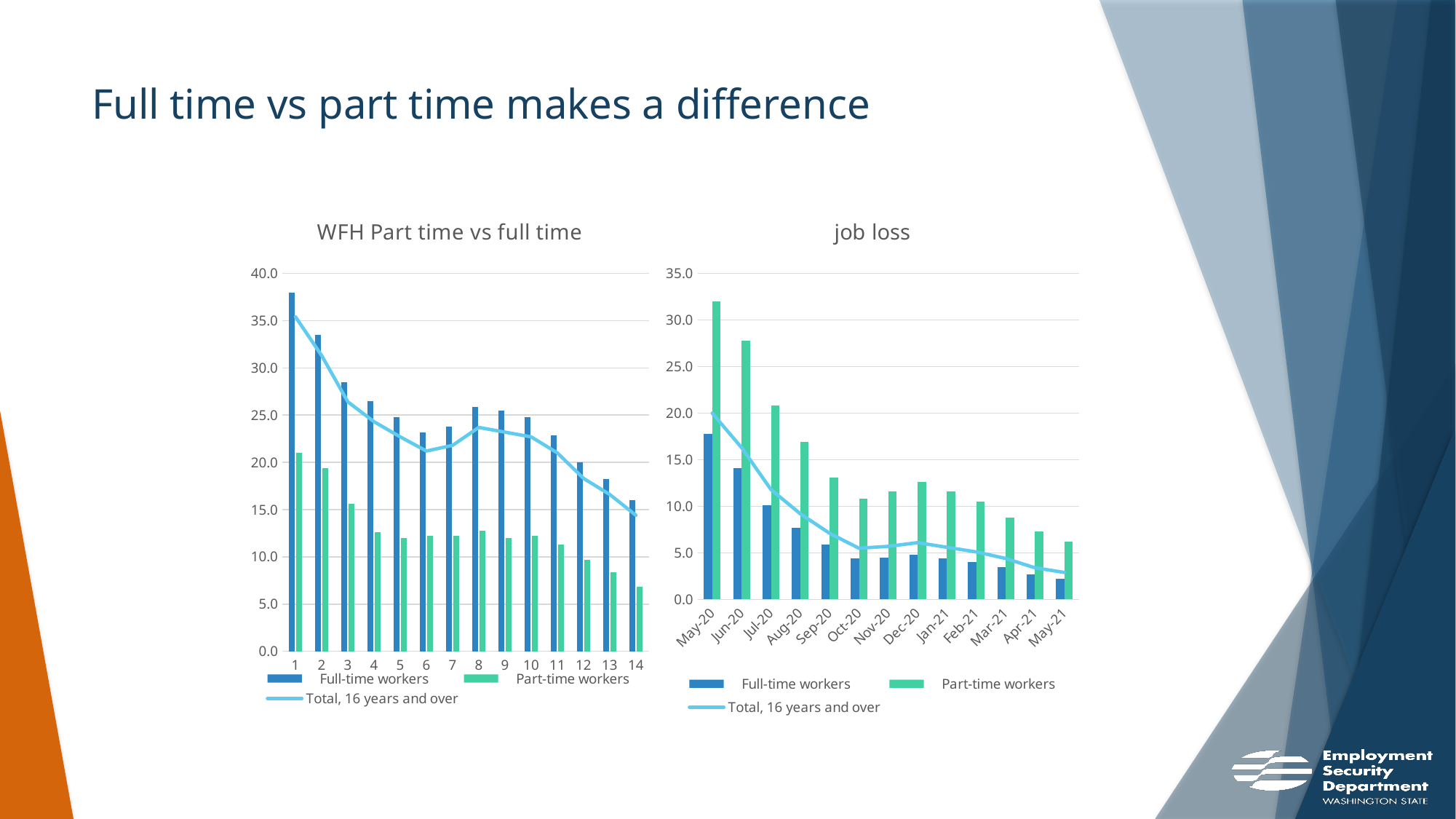
How many months are shown on the x axis of the "job loss" chart? 13 In the "WFH Part time vs full time" chart, is the value for Part-time workers at category 3 greater or less than 20.0? less In the "job loss" chart, does the "Total, 16 years and over" line generally rise or fall from May-20 to May-21? fall In the "WFH Part time vs full time" chart, is the value for Full-time workers at category 1 greater or less than 35.0? greater In the "job loss" chart, is the value for Full-time workers in Jul-20 greater or less than 15.0? less How many series does the legend of the "WFH Part time vs full time" chart list? 3 In the "WFH Part time vs full time" chart, which category has the highest value for Full-time workers? 1 In the "job loss" chart, which month has the highest value for Part-time workers? May-20 In the "WFH Part time vs full time" chart, which category has the lowest value for Part-time workers? 14 In the "job loss" chart, which is larger in Aug-20: Full-time workers or Part-time workers? Part-time workers In the "job loss" chart, which month has the lowest value for Full-time workers? May-21